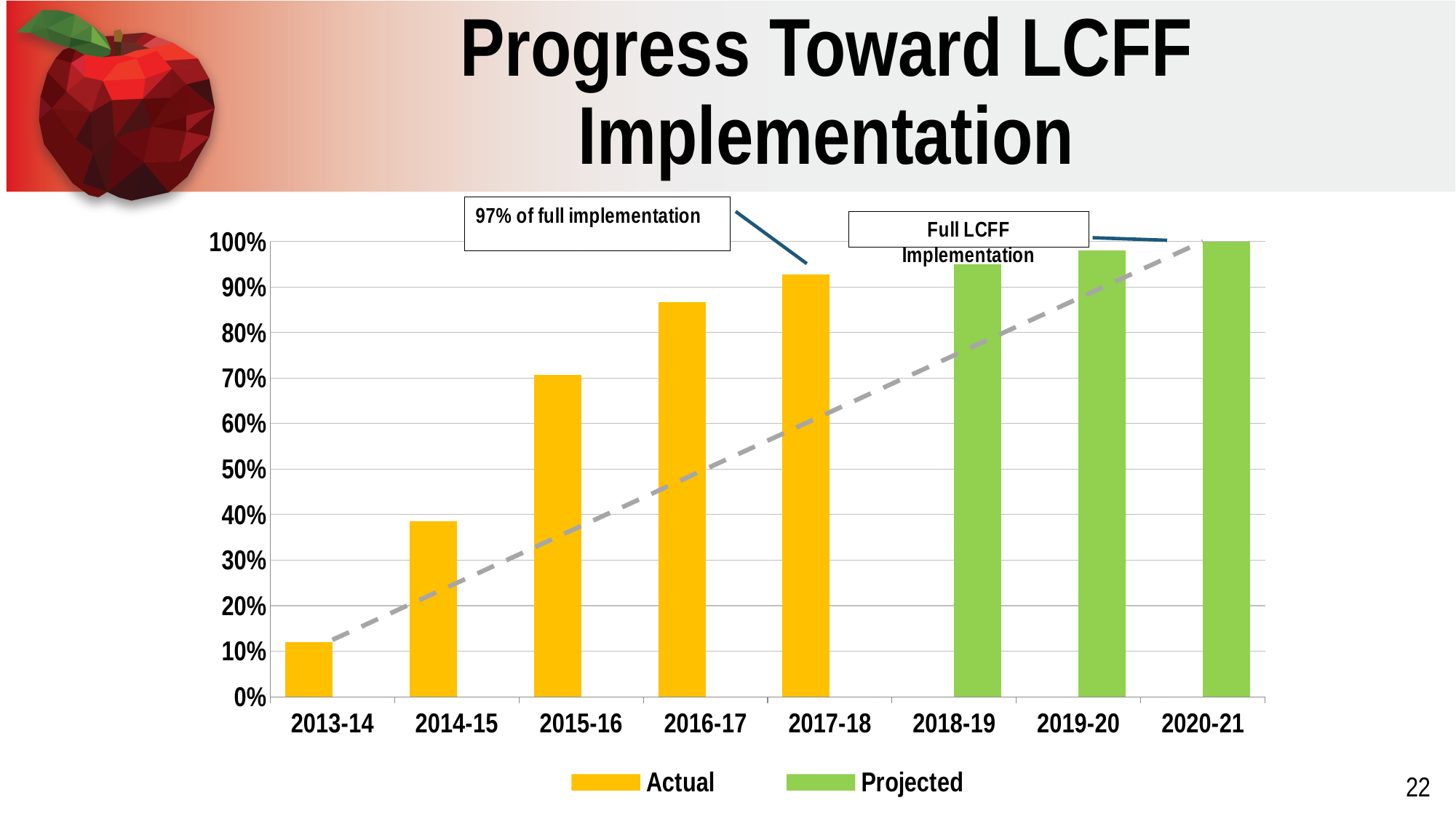
Which school year has the lowest bar in the chart? 2013-14 How many school years are shown on the x axis of the chart? 8 What are the two series named in the legend? Actual and Projected What kind of chart is shown on the slide? bar chart How many series does the chart's legend list? 2 What value does the bar for 2020-21 reach on the axis? 100% Which is larger, the value for 2015-16 or the value for 2014-15? 2015-16 Is the value for 2013-14 greater or less than 10%? greater Which school year has the highest bar in the chart? 2020-21 Is the value for 2014-15 greater or less than 50%? less Do the bar values rise or fall from 2013-14 to 2020-21? rise Is the value for 2016-17 greater or less than 80%? greater